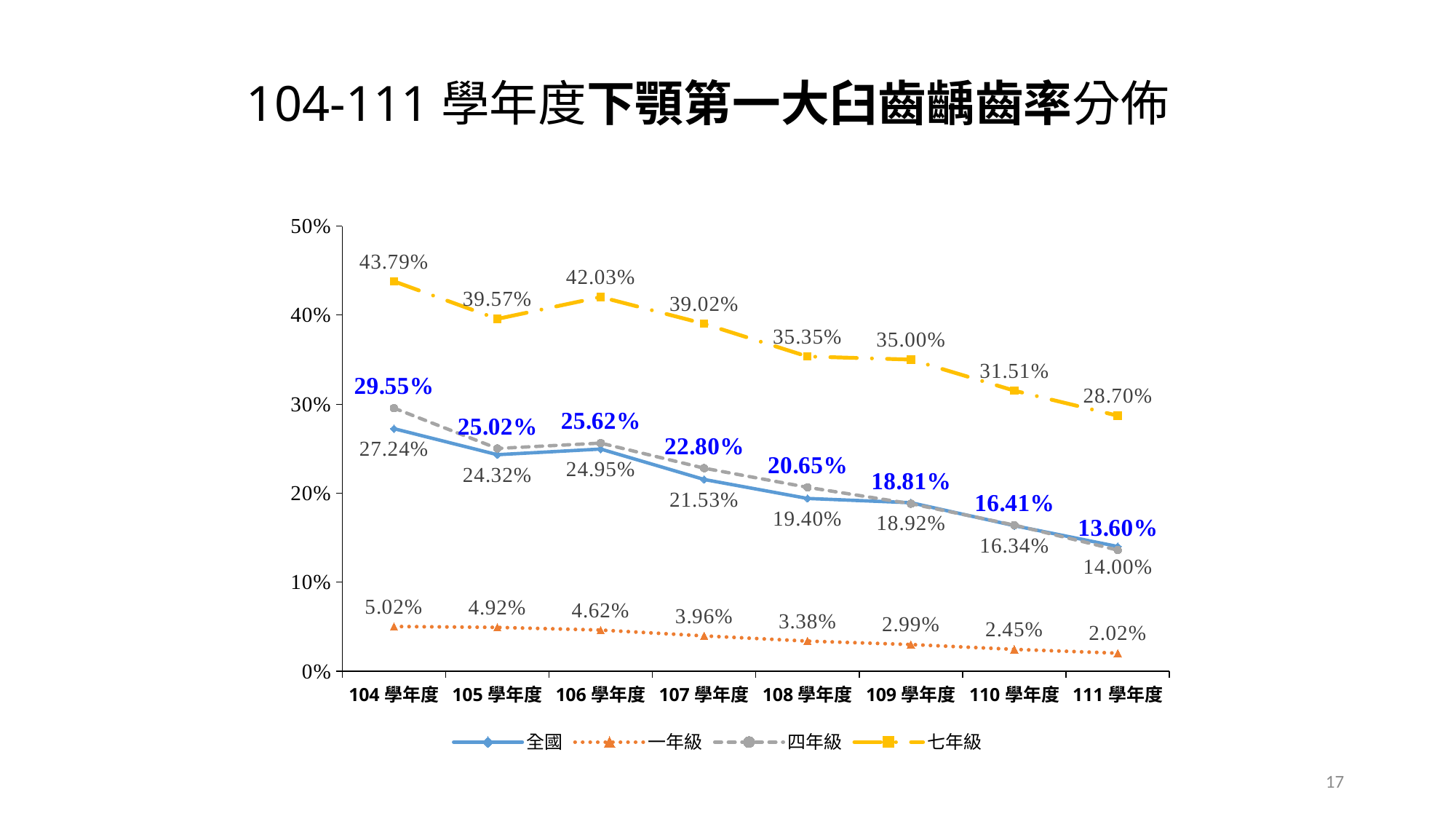
In which school year is the 七年級 value highest? 104 學年度 Which series is shown with the yellow dash-dot line? 七年級 How many series does the legend list? 4 What is the value for 七年級 in 104 學年度? 43.79% Which is larger for 七年級: the value in 105 學年度 or in 106 學年度? 106 學年度 What is the value for 七年級 in 108 學年度? 35.35% What is the difference between the 七年級 values in 104 學年度 and 111 學年度? 15.09 percentage points How many school years (學年度) are plotted along the x axis? 8 In which school year is the 一年級 value lowest? 111 學年度 Does the 一年級 line generally rise or fall from 104 學年度 to 111 學年度? fall What is the value for 一年級 in 111 學年度? 2.02% What kind of chart is shown on the slide? line chart